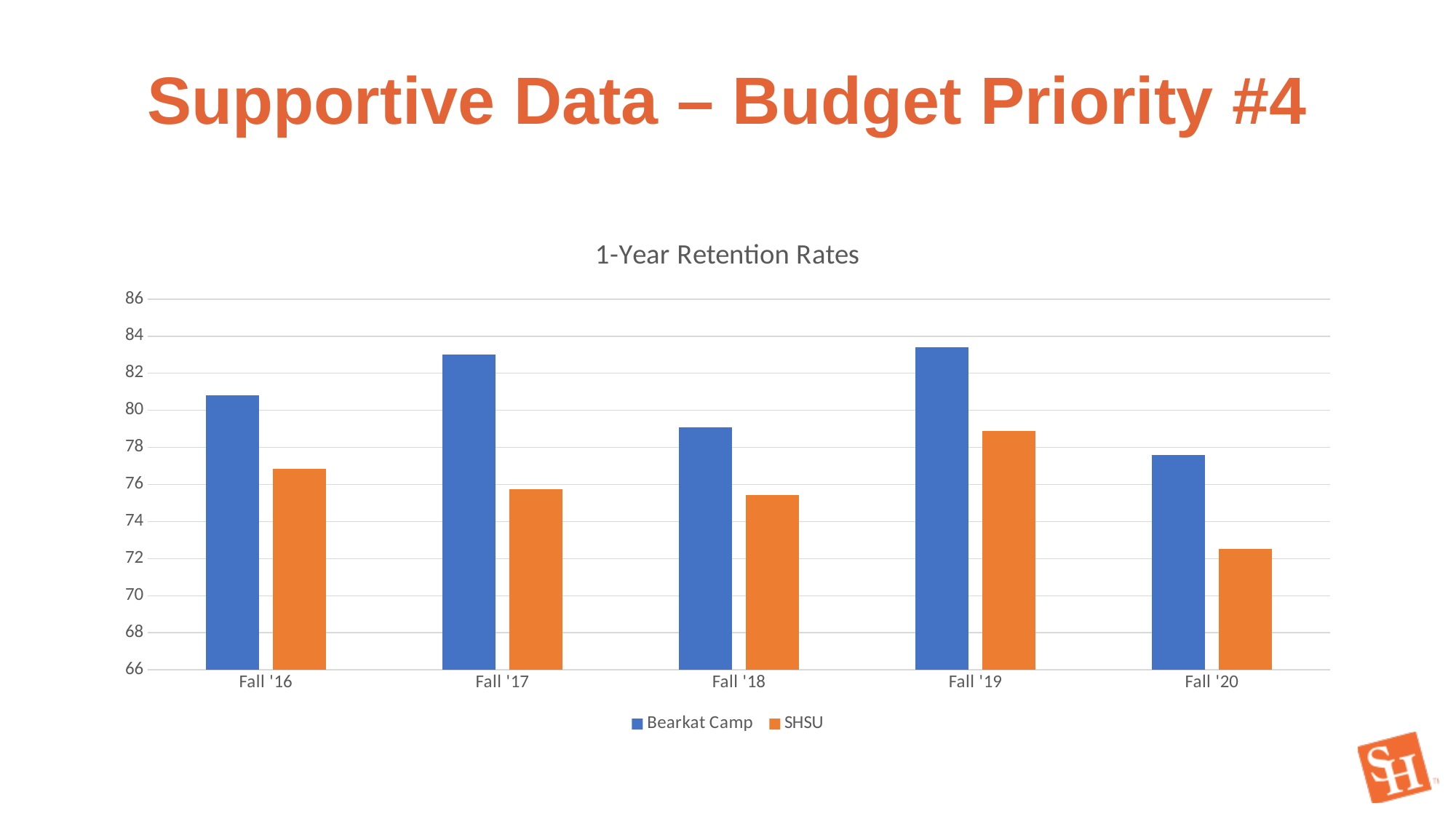
How many series does the legend list? 2 What is the title of the chart? 1-Year Retention Rates Which semester has the lowest Bearkat Camp retention rate? Fall '20 Which semester has the highest SHSU retention rate? Fall '19 How many semesters (categories) are shown on the x axis? 5 Which semester has the lowest SHSU retention rate? Fall '20 Is the Bearkat Camp value for Fall '16 greater or less than 80? greater What type of chart is shown on the slide? Bar chart Is the Bearkat Camp value for Fall '17 greater or less than 82? greater Which colour represents the SHSU series in the chart? Orange Is the SHSU value for Fall '20 greater or less than 74? less In Fall '18, which series has the higher retention rate, Bearkat Camp or SHSU? Bearkat Camp